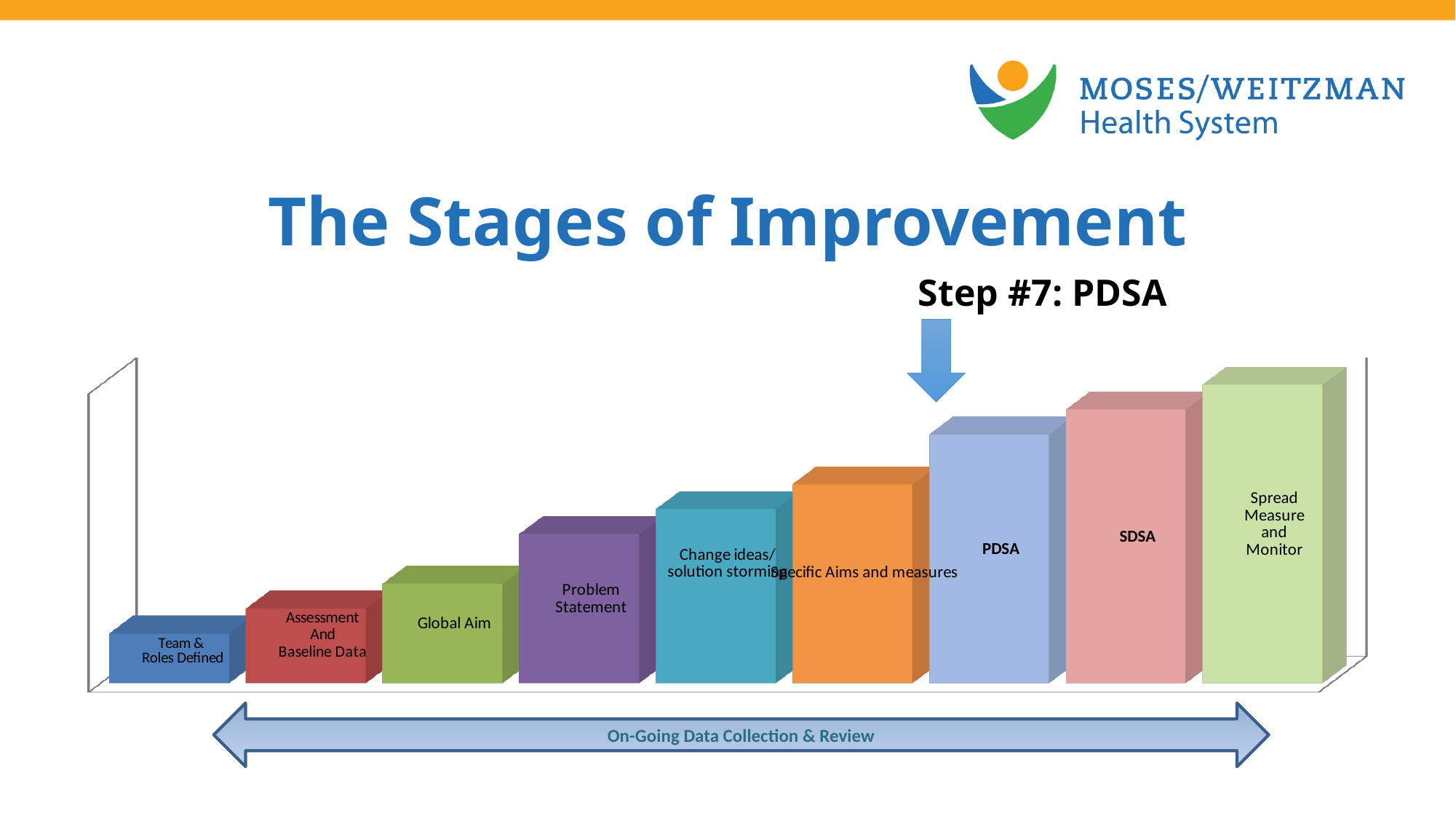
Which bar is taller, PDSA or Global Aim? PDSA Which bar is shorter, Assessment And Baseline Data or Specific Aims and measures? Assessment And Baseline Data How many bars are shown in the chart? 9 What is the label of the first bar on the left of the chart? Team & Roles Defined Which bar in the chart is the tallest? Spread Measure and Monitor Which bar is taller, SDSA or Problem Statement? SDSA Which bar does the arrow labelled "Step #7: PDSA" point to? PDSA Which bar in the chart is the shortest? Team & Roles Defined What is the title of the slide containing the chart? The Stages of Improvement What kind of chart is shown on the slide? Bar chart Do the bars rise or fall from left to right across the chart? Rise